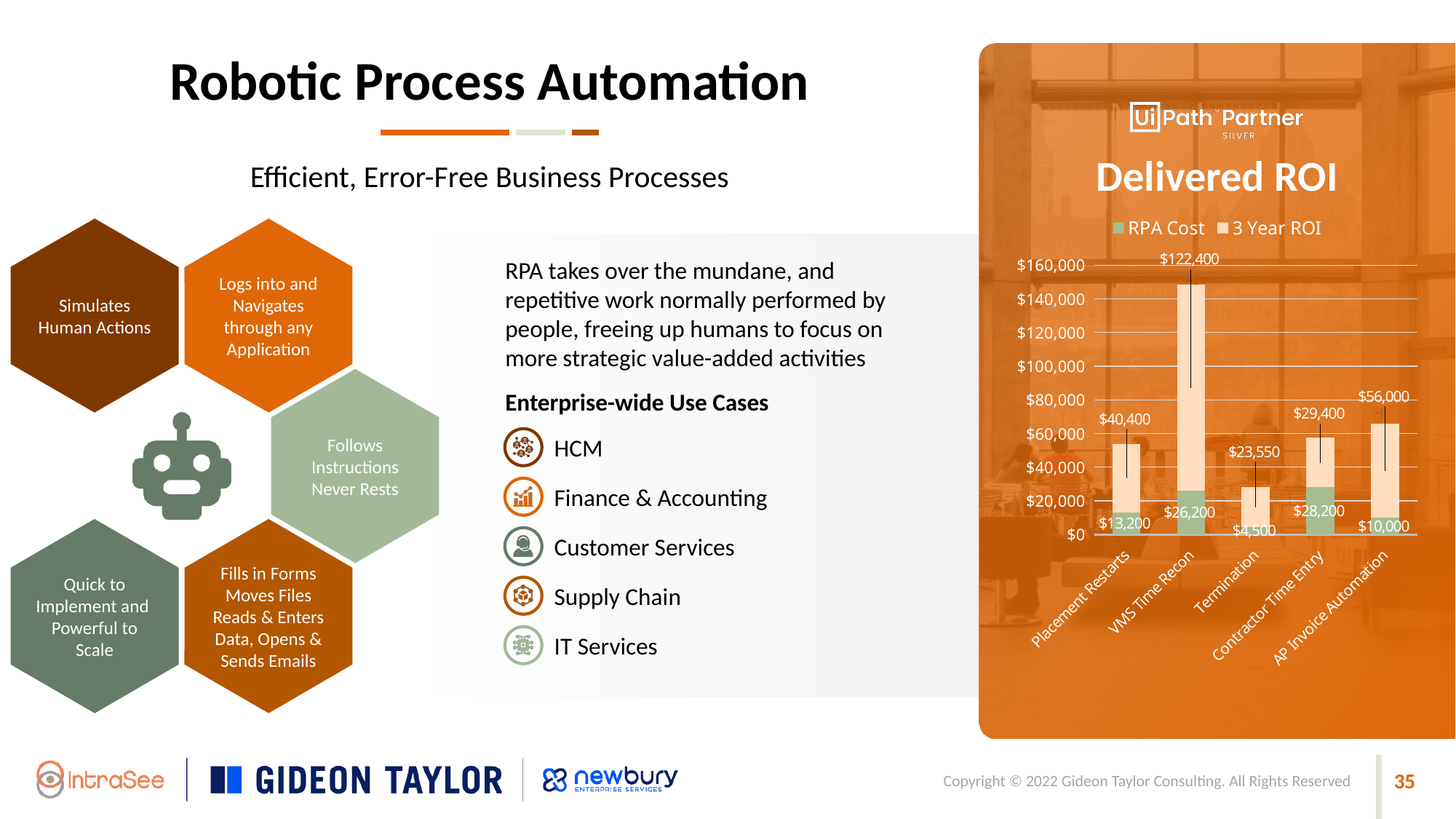
What is the RPA Cost for Contractor Time Entry? $28,200 What kind of chart is shown under the title "Delivered ROI"? Stacked bar chart What is the 3 Year ROI value for VMS Time Recon? $122,400 What are the two series named in the legend of the Delivered ROI chart? RPA Cost and 3 Year ROI How many categories are shown on the x axis of the Delivered ROI chart? 5 Which category has the lowest RPA Cost? Termination What is the RPA Cost for Termination? $4,500 Which is larger, the 3 Year ROI for Placement Restarts or the 3 Year ROI for Contractor Time Entry? Placement Restarts How many series does the legend of the Delivered ROI chart list? 2 What is the total height of the stacked bar for VMS Time Recon (RPA Cost plus 3 Year ROI)? $148,600 What is the difference between the 3 Year ROI and the RPA Cost for AP Invoice Automation? $46,000 Which category has the highest 3 Year ROI? VMS Time Recon